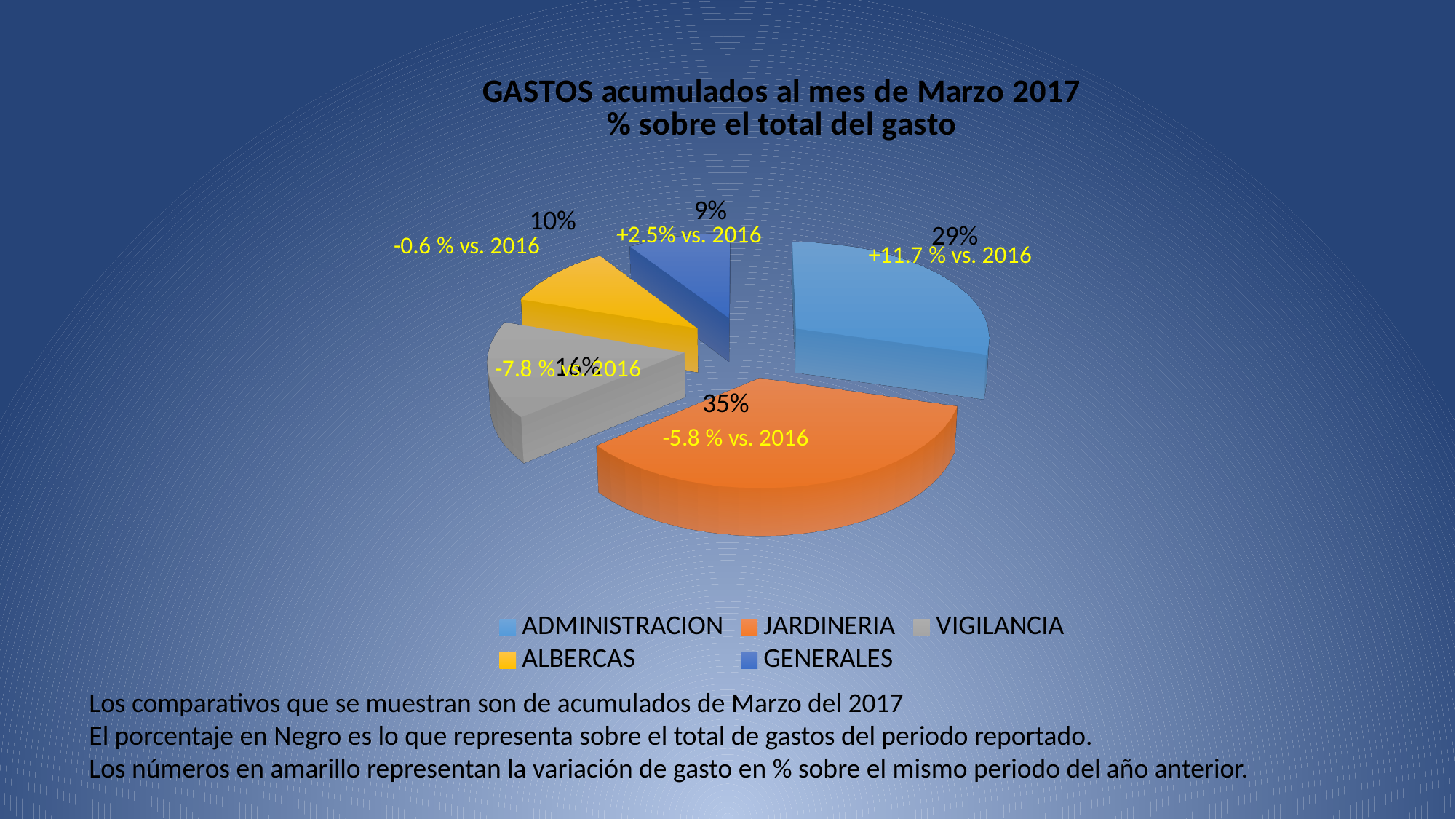
What is the difference in percentage points between the JARDINERIA and ADMINISTRACION shares? 6 What type of chart is shown on the slide? Pie chart What share of total expenses does ADMINISTRACION represent? 29% What share of total expenses does JARDINERIA represent? 35% What share of total expenses does VIGILANCIA represent? 16% What is the variation vs. 2016 shown in yellow for ADMINISTRACION? +11.7 % vs. 2016 Which has a larger share of total expenses, VIGILANCIA or ALBERCAS? VIGILANCIA What colour represents ALBERCAS in the chart? Yellow What share of total expenses does GENERALES represent? 9% Which category has the largest share of the total expenses? JARDINERIA Which category has the smallest share of the total expenses? GENERALES How many categories does the legend list? 5